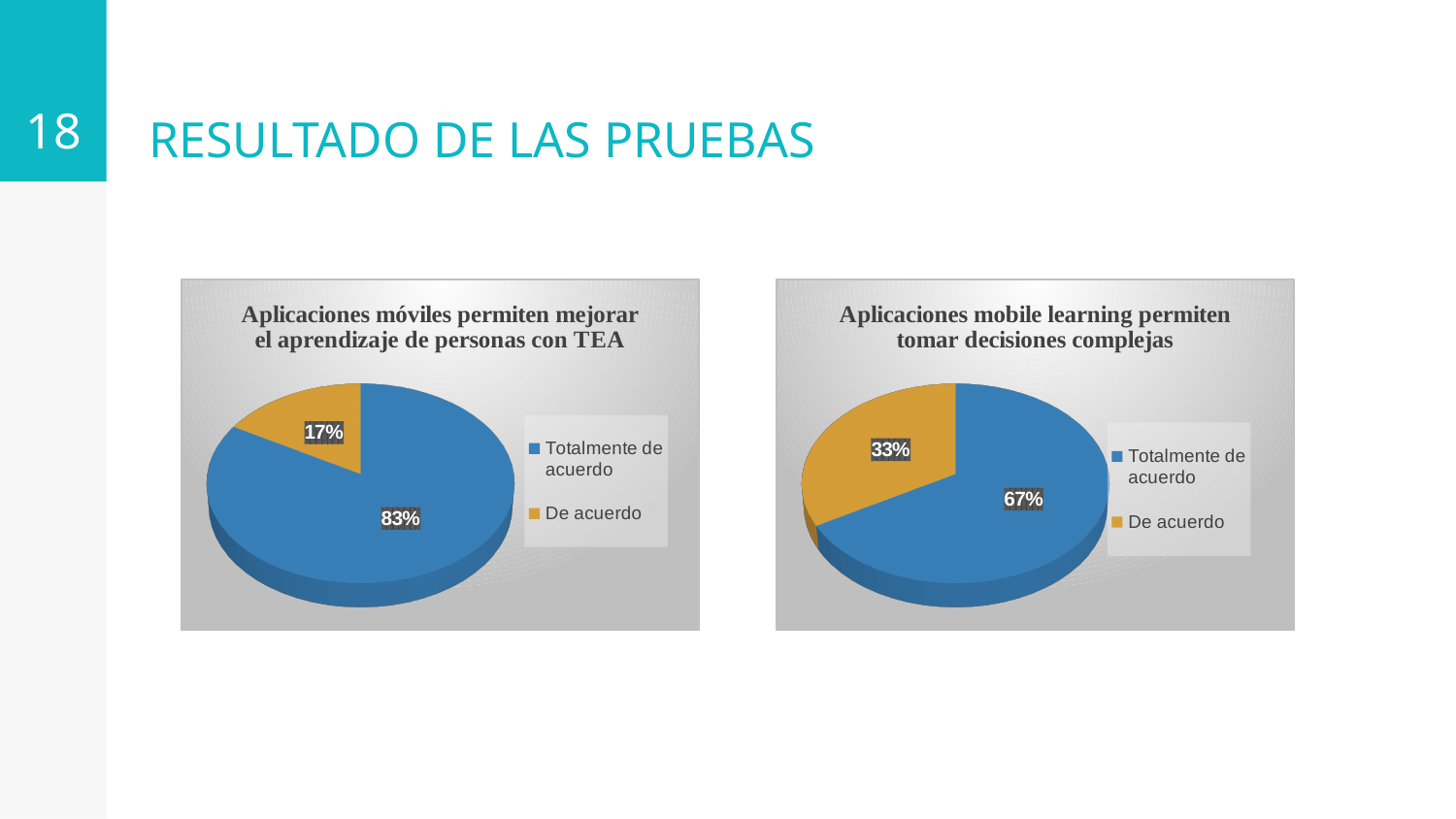
In the right chart, which category has the smallest slice? De acuerdo How many categories does the legend of the right chart list? 2 In the left chart, which category has the largest slice? Totalmente de acuerdo In the right chart titled 'Aplicaciones mobile learning permiten tomar decisiones complejas', what share is 'De acuerdo'? 33% In the right chart titled 'Aplicaciones mobile learning permiten tomar decisiones complejas', what share is 'Totalmente de acuerdo'? 67% In the right chart, what is the difference between the 'Totalmente de acuerdo' and 'De acuerdo' shares? 34% What kind of chart is the left chart? pie chart Which chart has the larger 'De acuerdo' share, the left chart or the right chart? the right chart In the right chart, what colour is the 'De acuerdo' slice? orange In the left chart, what is the difference between the 'Totalmente de acuerdo' and 'De acuerdo' shares? 66% In the left chart titled 'Aplicaciones móviles permiten mejorar el aprendizaje de personas con TEA', what share is 'De acuerdo'? 17% In the left chart titled 'Aplicaciones móviles permiten mejorar el aprendizaje de personas con TEA', what share is 'Totalmente de acuerdo'? 83%